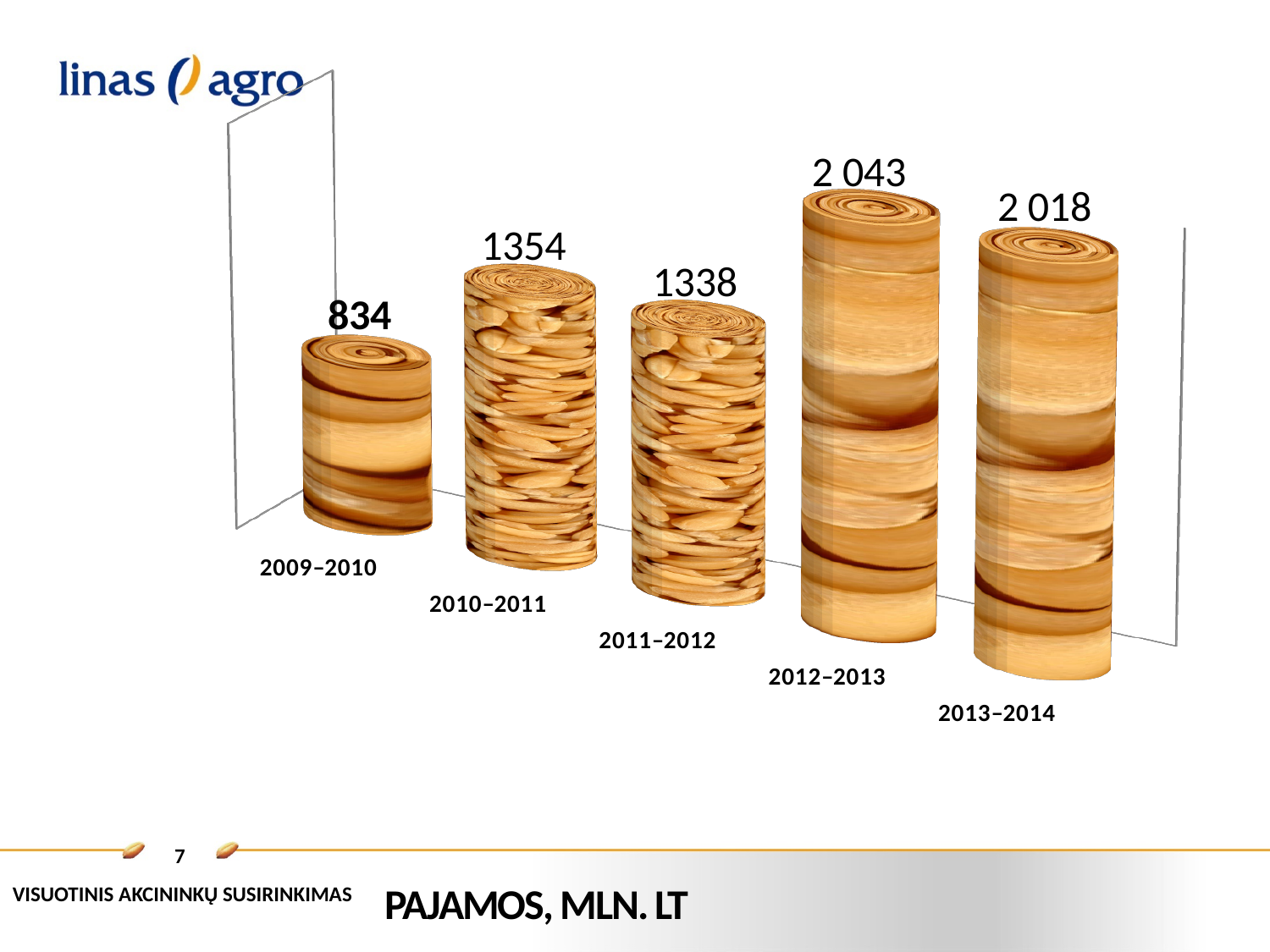
What kind of chart is shown on the slide? bar chart How many periods are shown on the chart? 5 Which period has the highest value? 2012–2013 What is the value for 2010–2011? 1354 What is the value for 2013–2014? 2 018 What is the difference between the values for 2012–2013 and 2013–2014? 25 Which period has the lowest value? 2009–2010 What is the difference between the values for 2010–2011 and 2009–2010? 520 Which is larger, the value for 2010–2011 or the value for 2011–2012? 2010–2011 What is the value for 2012–2013? 2 043 What is the title of the chart? PAJAMOS, MLN. LT What is the value for 2009–2010? 834